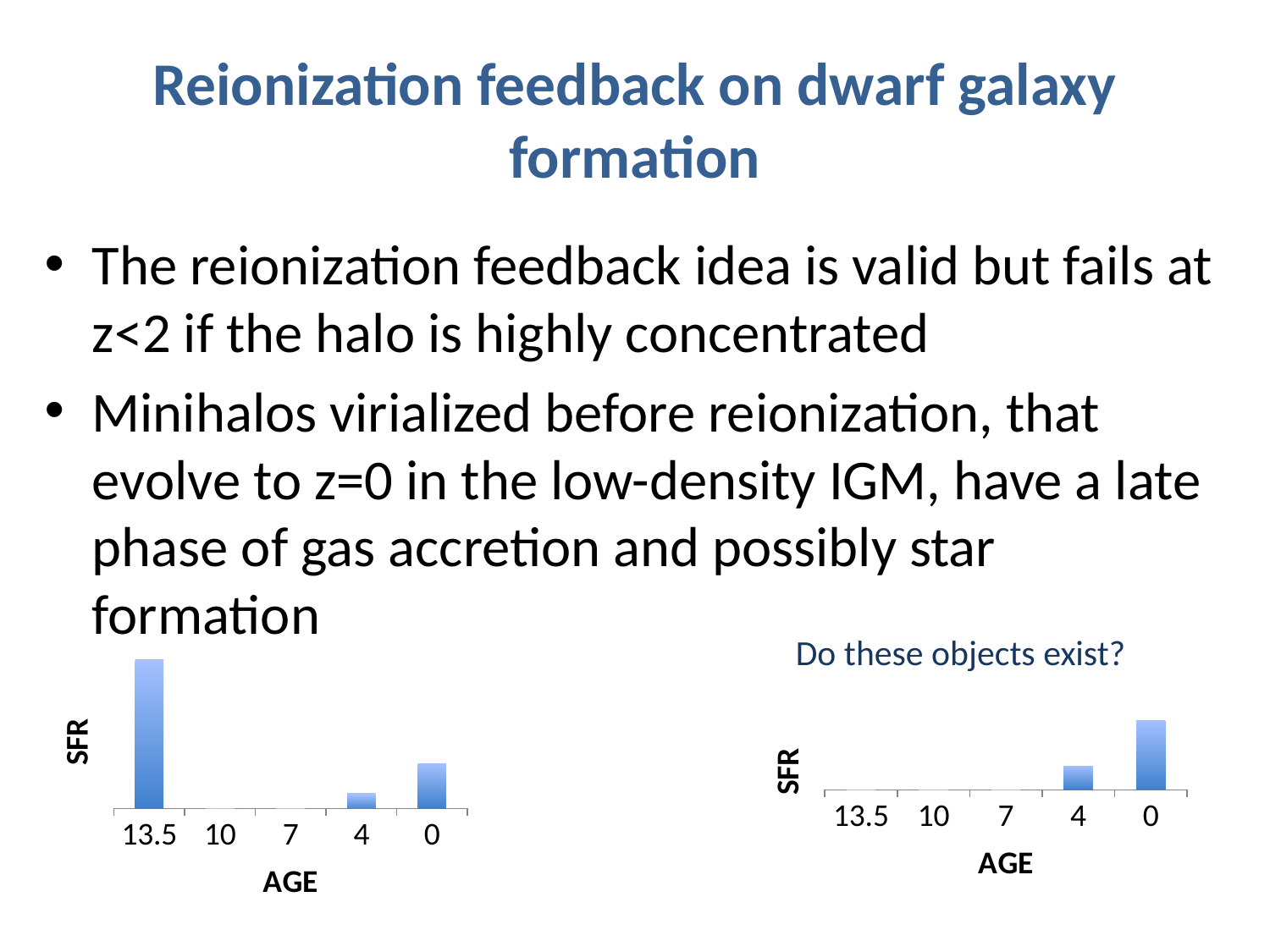
What kind of chart is the chart on the left of the slide? bar chart In the right chart, how many categories are labelled on the AGE axis? 5 In the right chart, which AGE category has the highest SFR? 0 What is the label on the vertical axis of the left chart? SFR In the right chart, is the SFR bar for AGE 4 taller or shorter than the bar for AGE 0? shorter What kind of chart is the chart on the right of the slide? bar chart In the left chart, how many categories are labelled on the AGE axis? 5 What is the label on the horizontal axis of the right chart? AGE In the left chart, is the SFR bar for AGE 0 taller or shorter than the bar for AGE 4? taller In the left chart, is the SFR bar for AGE 13.5 taller or shorter than the bar for AGE 0? taller In the left chart, which AGE category has the highest SFR? 13.5